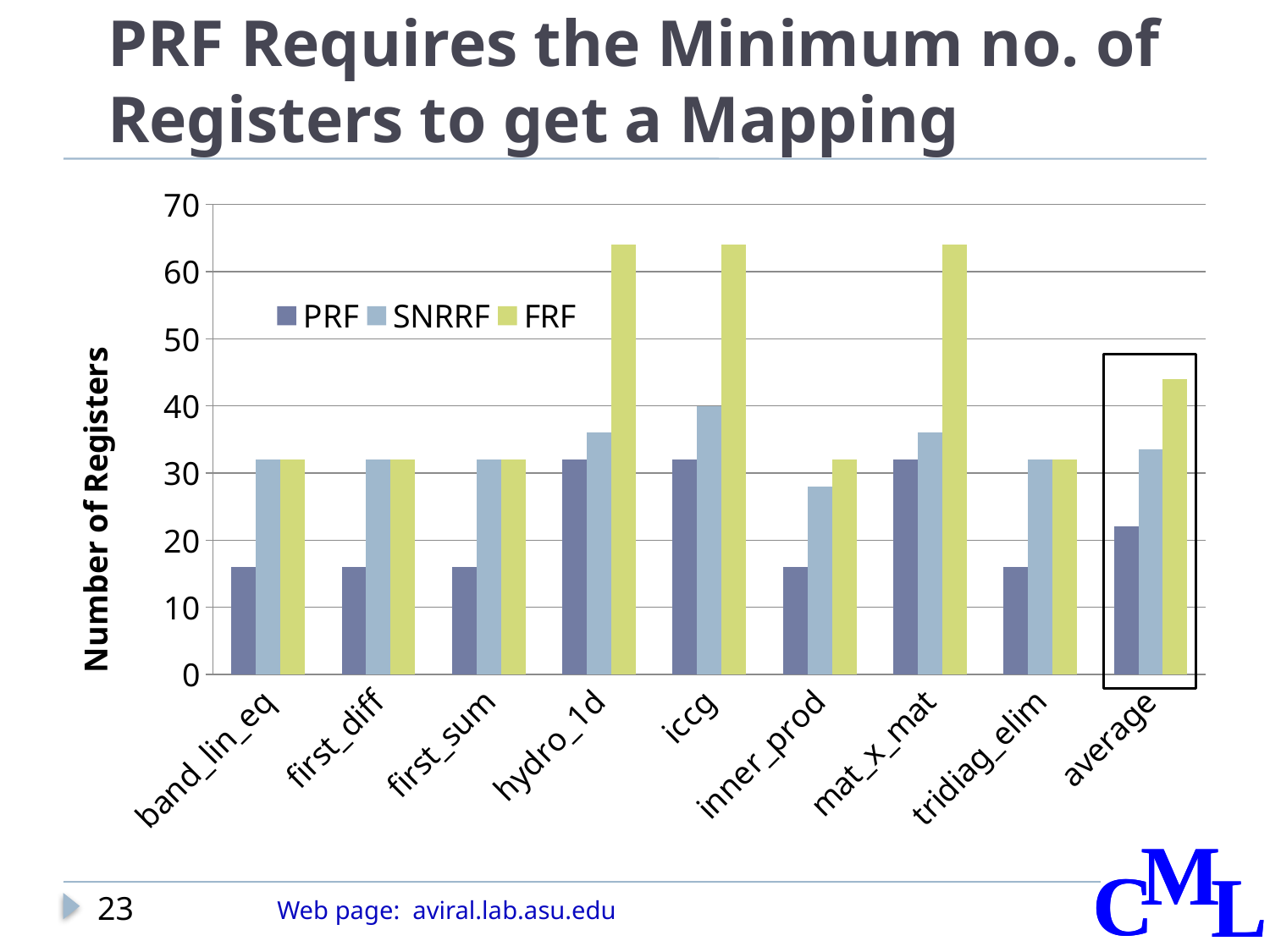
How many categories are shown along the x axis? 9 Is the FRF value for hydro_1d greater or less than 60? greater Which category has the highest SNRRF value? iccg How many series does the legend list? 3 What kind of chart is shown on the slide? bar chart Which category has the lowest SNRRF value? inner_prod Is the PRF value for band_lin_eq greater or less than 20? less For mat_x_mat, which is larger, the PRF value or the FRF value? FRF Is the FRF value for average greater or less than 40? greater What is the title of the y axis? Number of Registers Which series does the legend list first? PRF For inner_prod, which is larger, the SNRRF value or the FRF value? FRF